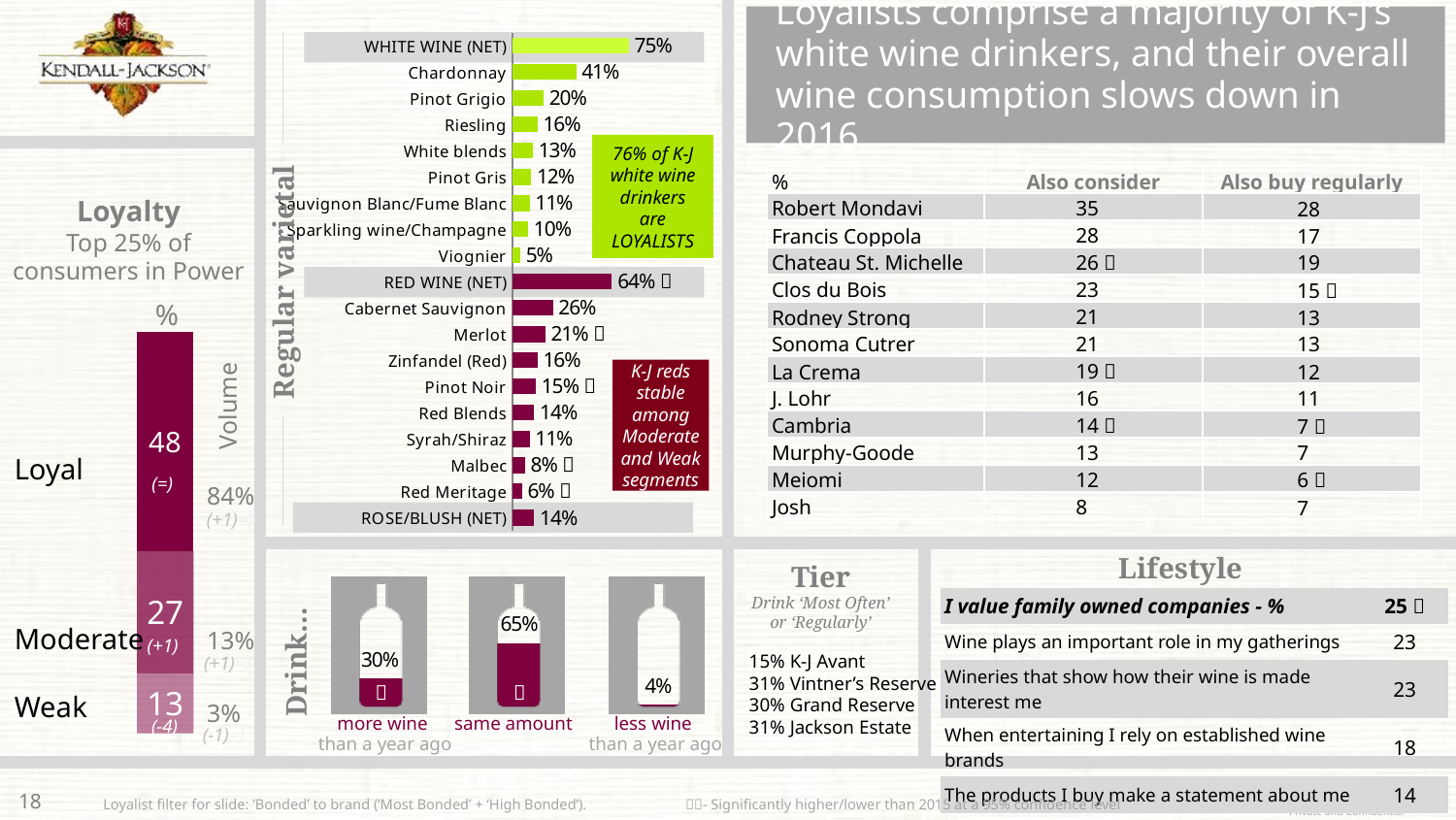
In the Loyalty chart on the left, what value is shown for the Loyal segment? 48 In the Drink chart at the bottom, what percentage drink the same amount as a year ago? 65% In the Regular varietal chart, which is larger, Merlot or Pinot Grigio? Merlot In the Loyalty chart on the left, which segment has the lowest value? Weak In the Regular varietal chart, which category has the highest value? WHITE WINE (NET) What type of chart is the Regular varietal chart? Bar chart In the Regular varietal chart, what percentage is shown for Cabernet Sauvignon? 26% In the Drink chart at the bottom, which category has the highest value? same amount In the Regular varietal chart, what is the difference between WHITE WINE (NET) and RED WINE (NET)? 11 percentage points In the Drink chart at the bottom, what is the difference between 'more wine than a year ago' and 'less wine than a year ago'? 26 percentage points In the Regular varietal chart, what percentage is shown for Chardonnay? 41% In the Regular varietal chart, which category has the lowest value? Viognier